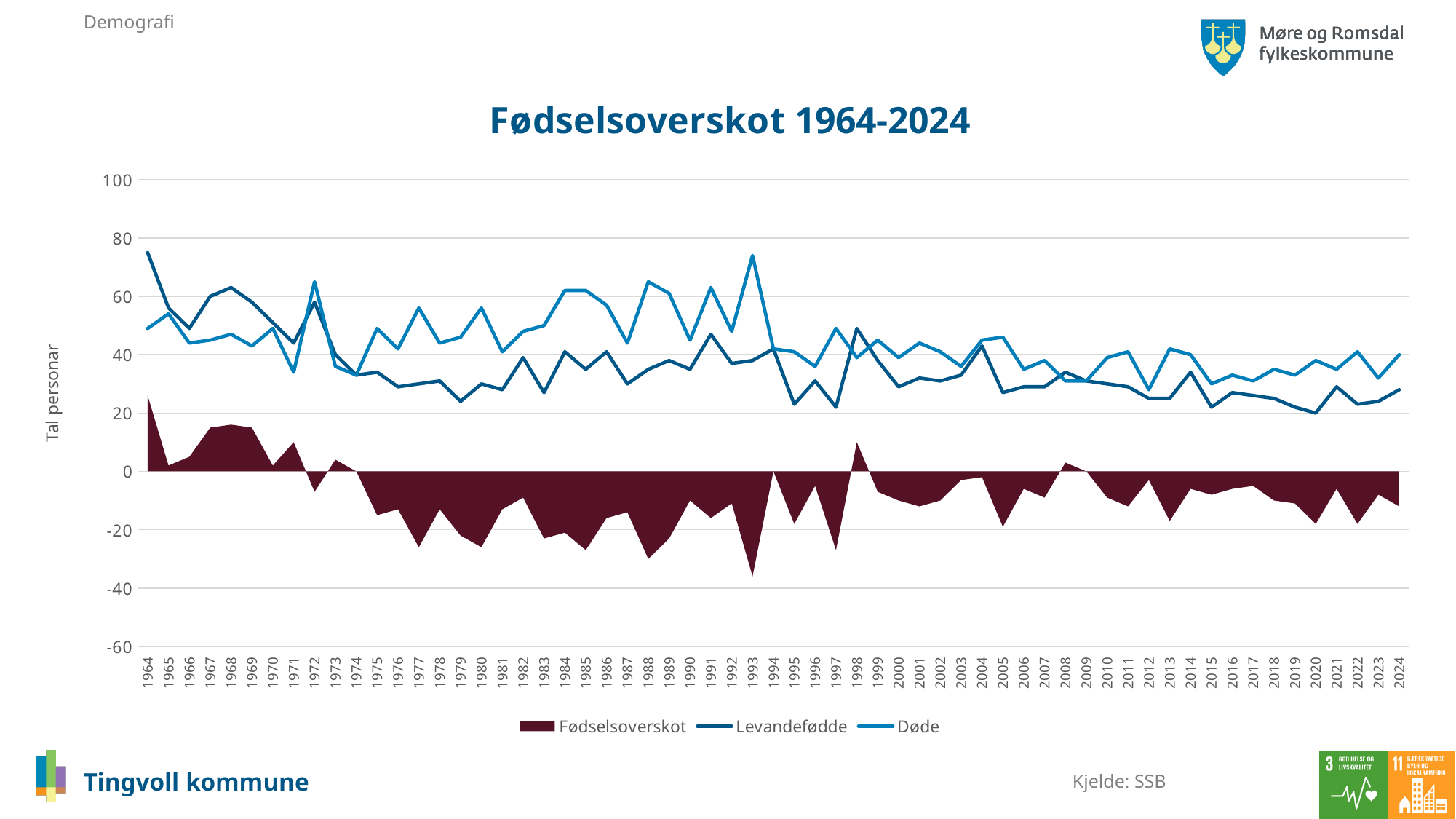
What is the title of the chart? Fødselsoverskot 1964-2024 What kind of chart is this? A combination of an area chart and a line chart Does Levandefødde generally rise or fall from 1964 to 2024? Fall Is the value for Døde in 1993 greater or less than 60? greater Is the value for Levandefødde in 1964 greater or less than 60? greater In 2024, which is larger, Levandefødde or Døde? Døde Is the value for Fødselsoverskot in 1993 greater or less than -20? less In which year is Levandefødde highest? 1964 In which year is Fødselsoverskot lowest? 1993 How many series does the legend list? 3 How many years are shown on the x axis? 61